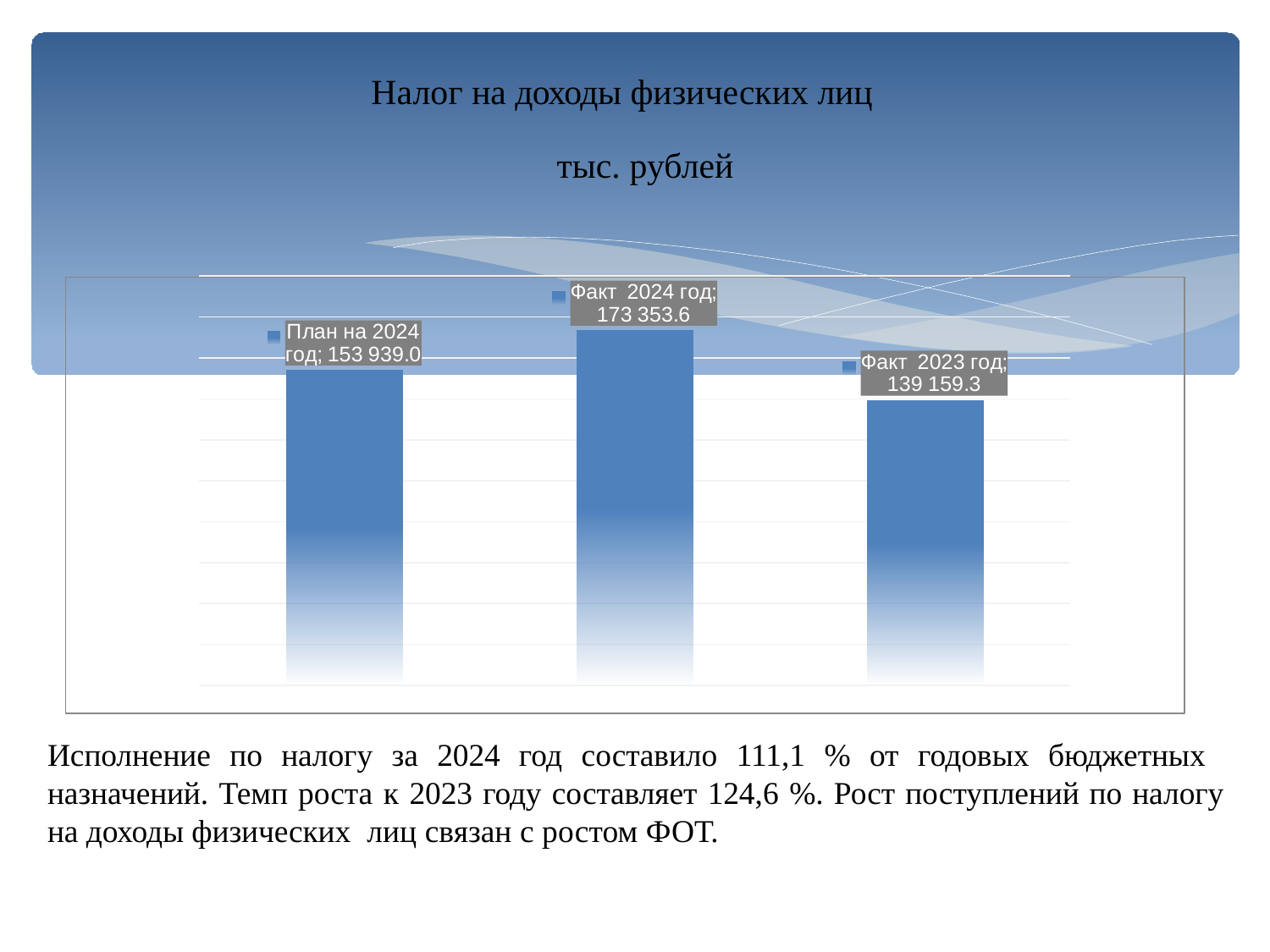
What is the value for План на 2024 год? 153 939.0 What is the difference between Факт 2024 год and Факт 2023 год? 34 194.3 What is the title of the chart? Налог на доходы физических лиц Which category has the highest value? Факт 2024 год What is the value for Факт 2023 год? 139 159.3 What kind of chart is shown on the slide? Bar chart How many bars are shown in the chart? 3 Which is larger, Факт 2024 год or План на 2024 год? Факт 2024 год What is the value for Факт 2024 год? 173 353.6 What is the difference between План на 2024 год and Факт 2023 год? 14 779.7 Which category has the lowest value? Факт 2023 год What is the difference between Факт 2024 год and План на 2024 год? 19 414.6